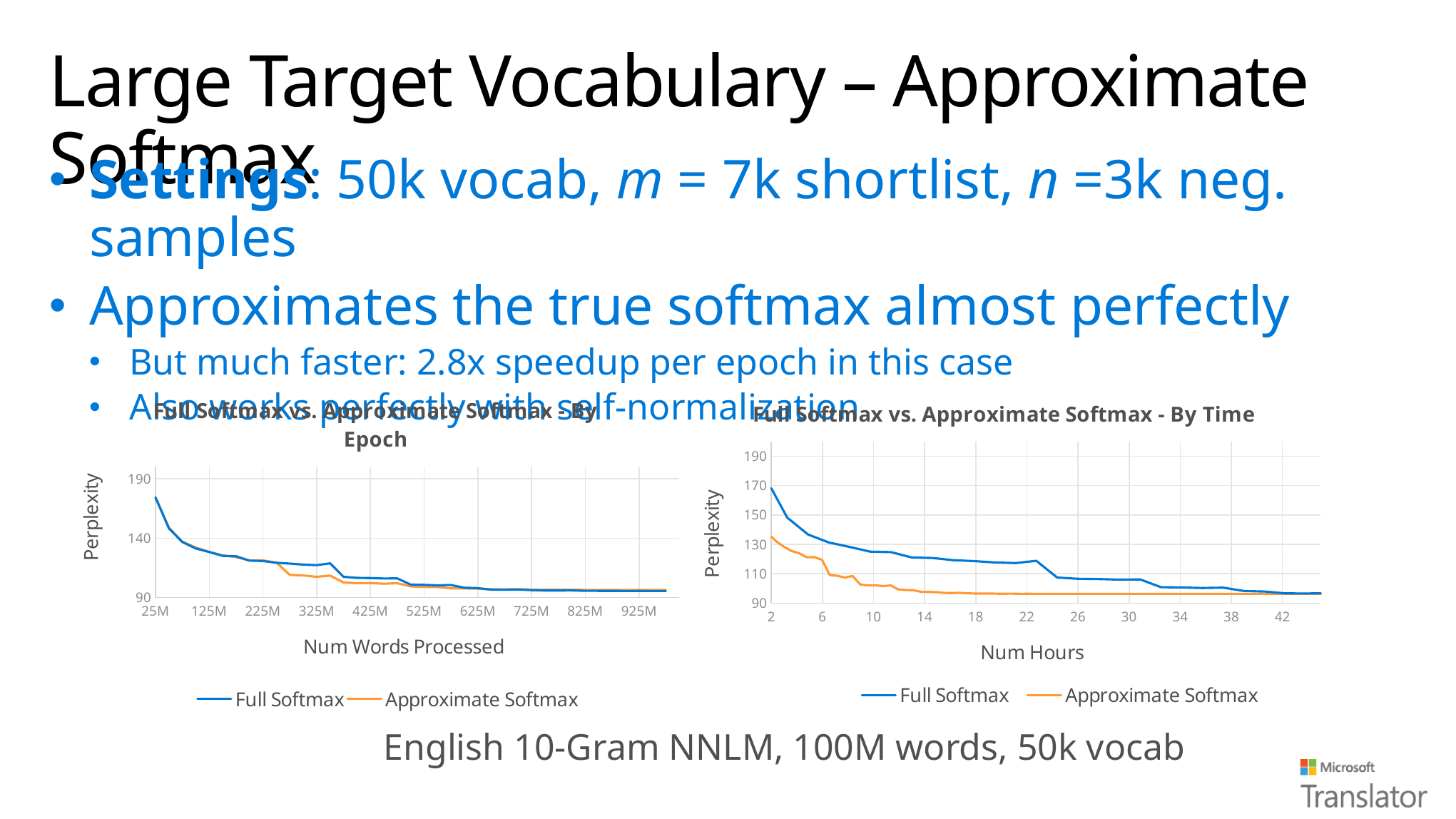
In the 'Full Softmax vs. Approximate Softmax - By Time' chart, which series has the higher perplexity at 10 hours, Full Softmax or Approximate Softmax? Full Softmax In the 'Full Softmax vs. Approximate Softmax - By Epoch' chart, does the Full Softmax perplexity rise or fall as the number of words processed increases? fall In the 'Full Softmax vs. Approximate Softmax - By Epoch' chart, is the Full Softmax perplexity at 25M words greater or less than 140? greater In the 'Full Softmax vs. Approximate Softmax - By Epoch' chart, which series has the higher perplexity at 425M words processed, Full Softmax or Approximate Softmax? Full Softmax How many series does the legend of the 'Full Softmax vs. Approximate Softmax - By Epoch' chart list? 2 In the 'Full Softmax vs. Approximate Softmax - By Time' chart, is the Full Softmax perplexity at 42 hours greater or less than 110? less In the 'Full Softmax vs. Approximate Softmax - By Time' chart, does the Approximate Softmax perplexity rise or fall as the number of hours increases? fall What is the x-axis title of the 'Full Softmax vs. Approximate Softmax - By Time' chart? Num Hours In the 'Full Softmax vs. Approximate Softmax - By Time' chart, which series does the legend list besides Full Softmax? Approximate Softmax What kind of chart is the 'Full Softmax vs. Approximate Softmax - By Time' chart? line chart In the 'Full Softmax vs. Approximate Softmax - By Time' chart, is the Full Softmax perplexity at 2 hours greater or less than 150? greater What kind of chart is the 'Full Softmax vs. Approximate Softmax - By Epoch' chart? line chart